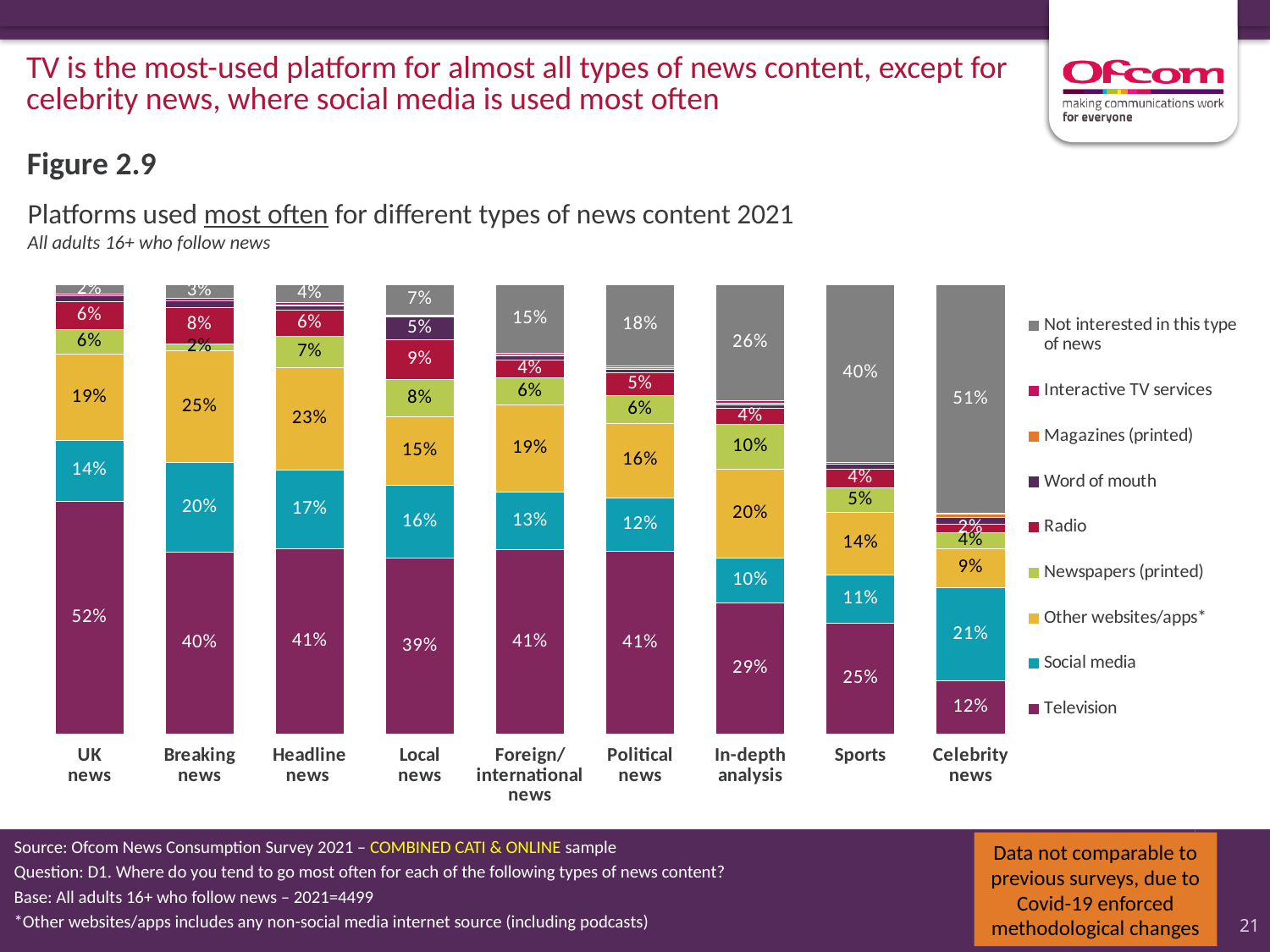
What is the 'Other websites/apps' value for breaking news? 25% How many series does the legend list? 9 Which type of news content has the highest television value? UK news What percentage of adults use social media most often for celebrity news? 21% Which is larger for in-depth analysis: the television value or the 'Not interested in this type of news' value? Television What is the difference between the television values for UK news and breaking news? 12% What kind of chart is shown on the slide? Stacked bar chart Which type of news content has the lowest television value? Celebrity news What percentage of adults use television most often for UK news? 52% What is the 'Not interested in this type of news' value for sports? 40% Which legend entry is shown in grey? Not interested in this type of news How many types of news content are shown on the x axis? 9